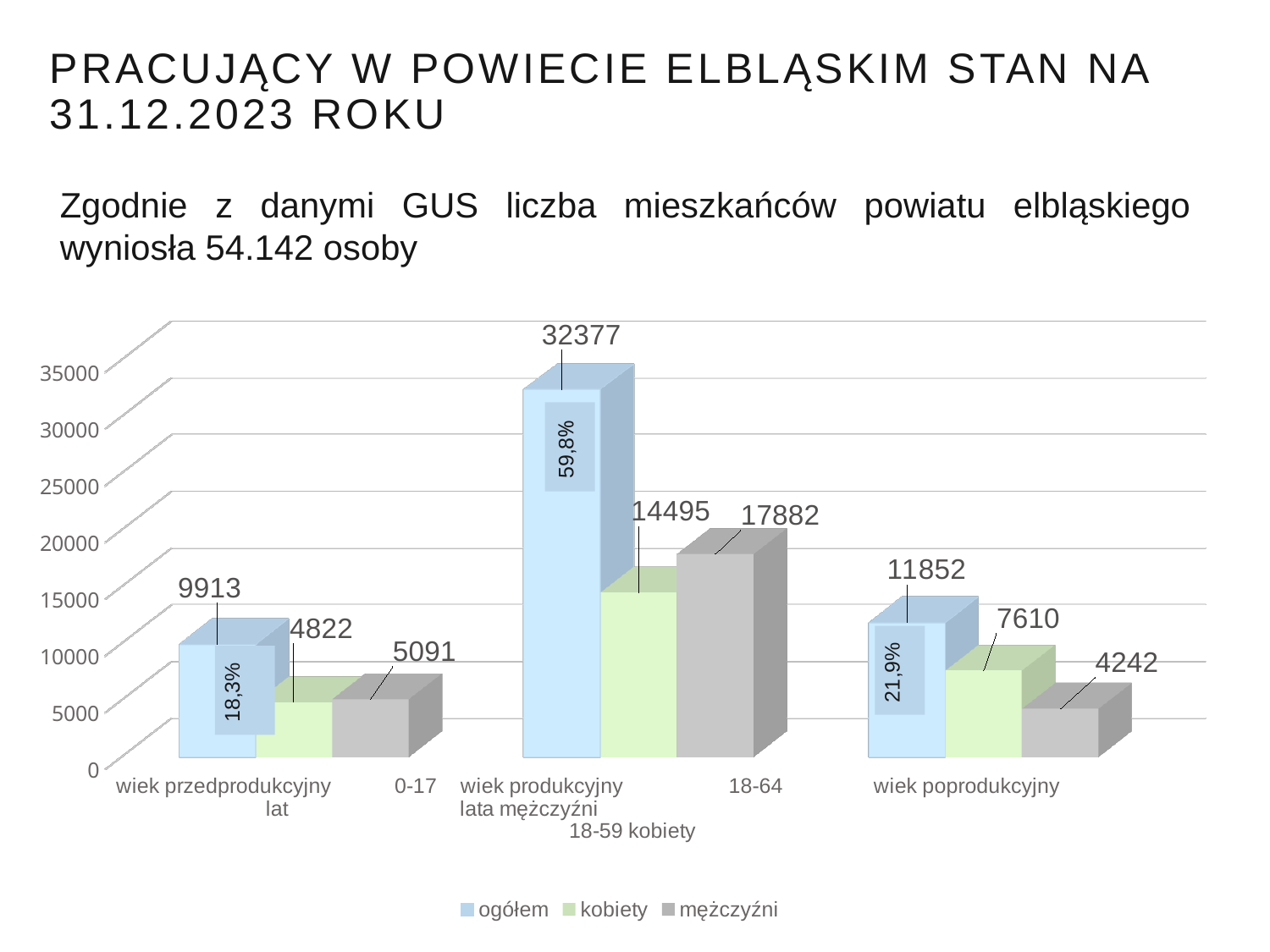
How many series does the legend list? 3 How many categories are shown on the x axis? 3 What is the value for ogółem in the wiek produkcyjny category? 32377 In the wiek poprodukcyjny category, which is larger: kobiety or mężczyźni? kobiety Which category has the highest ogółem value? wiek produkcyjny What percentage is shown inside the ogółem bar for wiek poprodukcyjny? 21,9% Which series is shown in green in the legend? kobiety What is the difference between the mężczyźni and kobiety values in the wiek produkcyjny category? 3387 What is the value for mężczyźni in the wiek przedprodukcyjny category? 5091 Which category has the lowest mężczyźni value? wiek poprodukcyjny What is the value for kobiety in the wiek poprodukcyjny category? 7610 What kind of chart is shown on the slide? bar chart